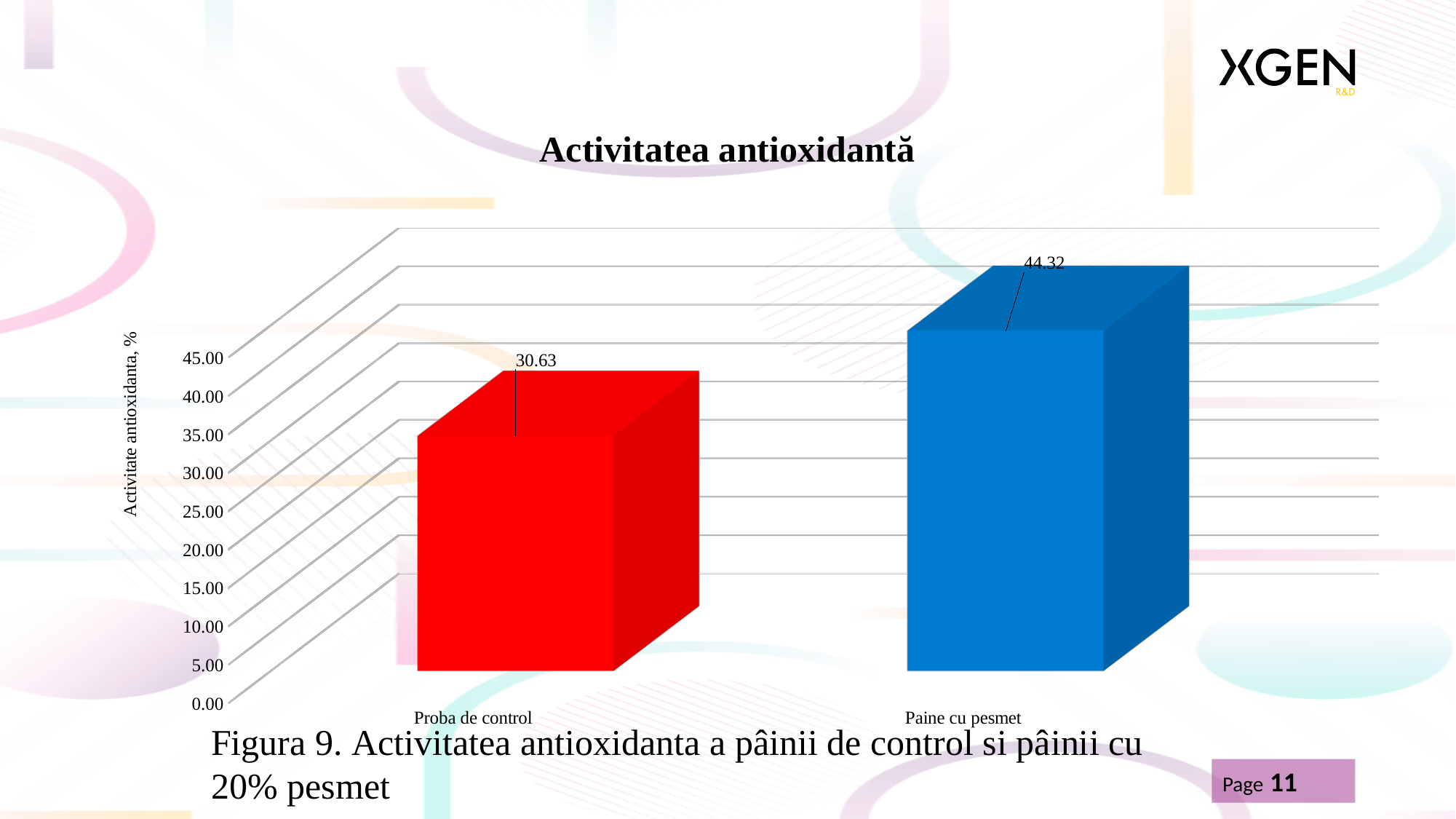
What is the value for Proba de control? 30.63 Which category has the lowest antioxidant activity? Proba de control Is the value for Paine cu pesmet greater or less than 40.00? greater What is the label of the vertical axis? Activitate antioxidanta, % What is the difference between the values for Paine cu pesmet and Proba de control? 13.69 Is the value for Proba de control greater or less than 35.00? less What kind of chart is shown on the slide? bar chart What is the title of the chart? Activitatea antioxidantă Which is larger, the value for Proba de control or the value for Paine cu pesmet? Paine cu pesmet What is the value for Paine cu pesmet? 44.32 How many categories are shown in the chart? 2 Which category has the highest antioxidant activity? Paine cu pesmet